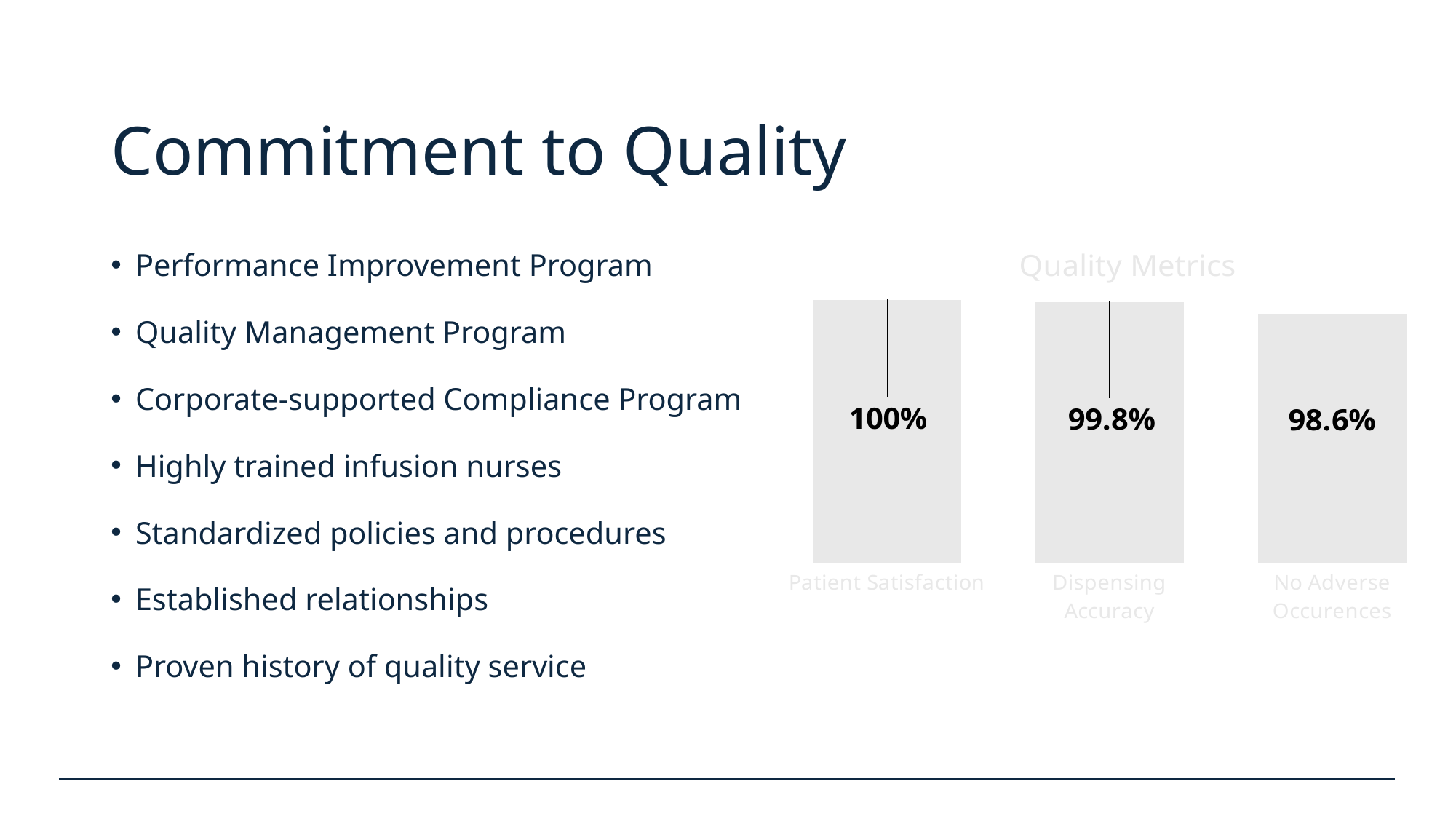
What is the difference between the Patient Satisfaction and Dispensing Accuracy values in the Quality Metrics chart? 0.2% Which category has the lowest value in the Quality Metrics chart? No Adverse Occurences Do the values in the Quality Metrics chart rise or fall from left to right? Fall Which category has the highest value in the Quality Metrics chart? Patient Satisfaction In the Quality Metrics chart, which is larger: Dispensing Accuracy or No Adverse Occurences? Dispensing Accuracy What is the value for No Adverse Occurences in the Quality Metrics chart? 98.6% What is the value for Dispensing Accuracy in the Quality Metrics chart? 99.8% What is the value for Patient Satisfaction in the Quality Metrics chart? 100% What is the difference between the Dispensing Accuracy and No Adverse Occurences values in the Quality Metrics chart? 1.2% What kind of chart is the Quality Metrics chart? Bar chart How many categories are shown in the Quality Metrics chart? 3 What is the title of the chart on the slide? Quality Metrics